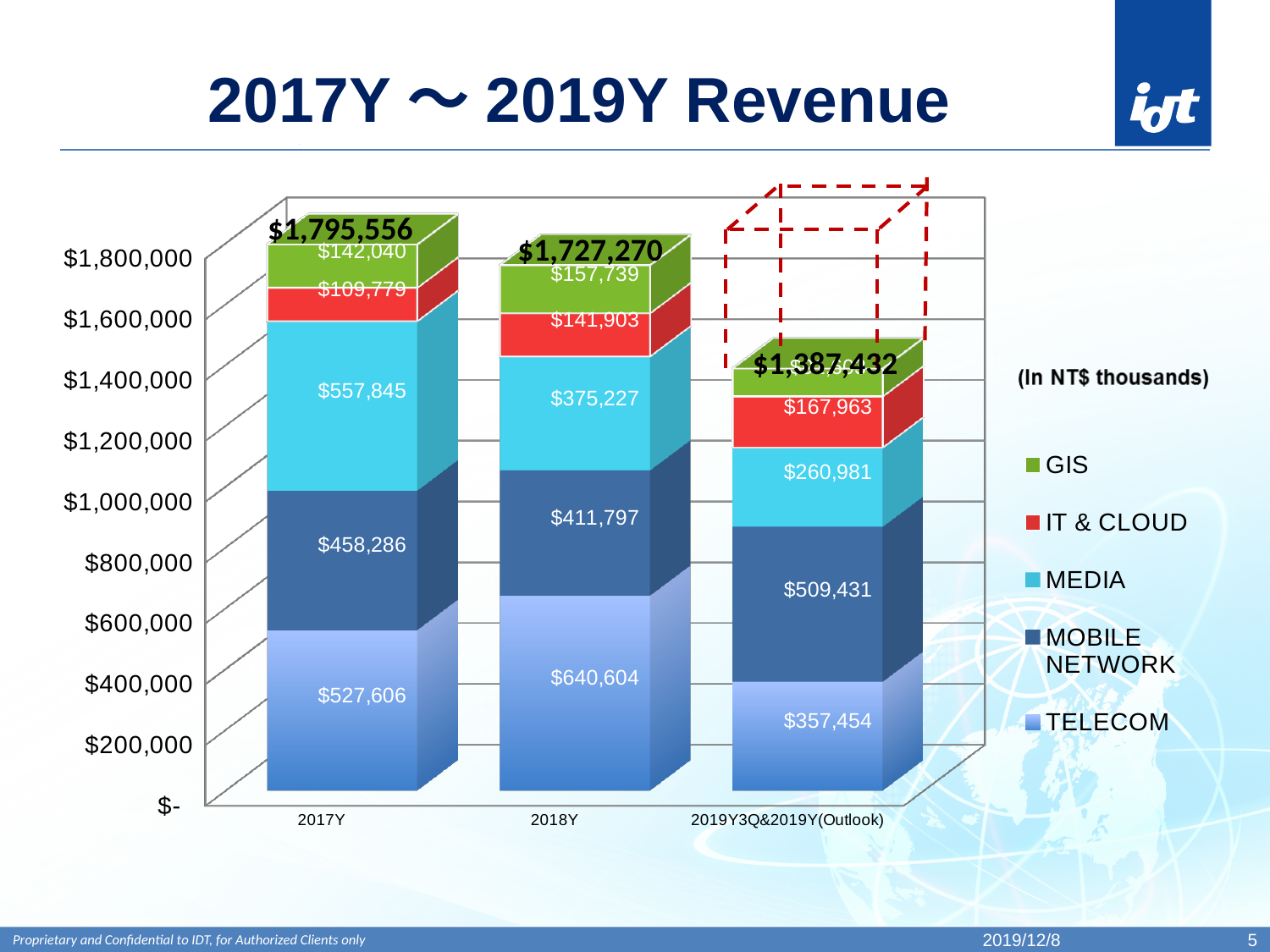
Do the total revenues rise or fall from 2017Y to 2019Y3Q&2019Y(Outlook)? Fall What is the difference between the TELECOM values for 2018Y and 2017Y? $112,998 Which is larger, the MOBILE NETWORK value for 2018Y or for 2019Y3Q&2019Y(Outlook)? 2019Y3Q&2019Y(Outlook) What is the MEDIA value for 2017Y? $557,845 How many series does the legend list? 5 What is the TELECOM value for 2018Y? $640,604 What kind of chart is shown on the slide? Stacked bar chart What is the difference between the MEDIA values for 2017Y and 2018Y? $182,618 Which category has the lowest total revenue? 2019Y3Q&2019Y(Outlook) What is the total revenue shown for 2018Y? $1,727,270 What is the IT & CLOUD value for 2019Y3Q&2019Y(Outlook)? $167,963 Which year has the highest total revenue? 2017Y